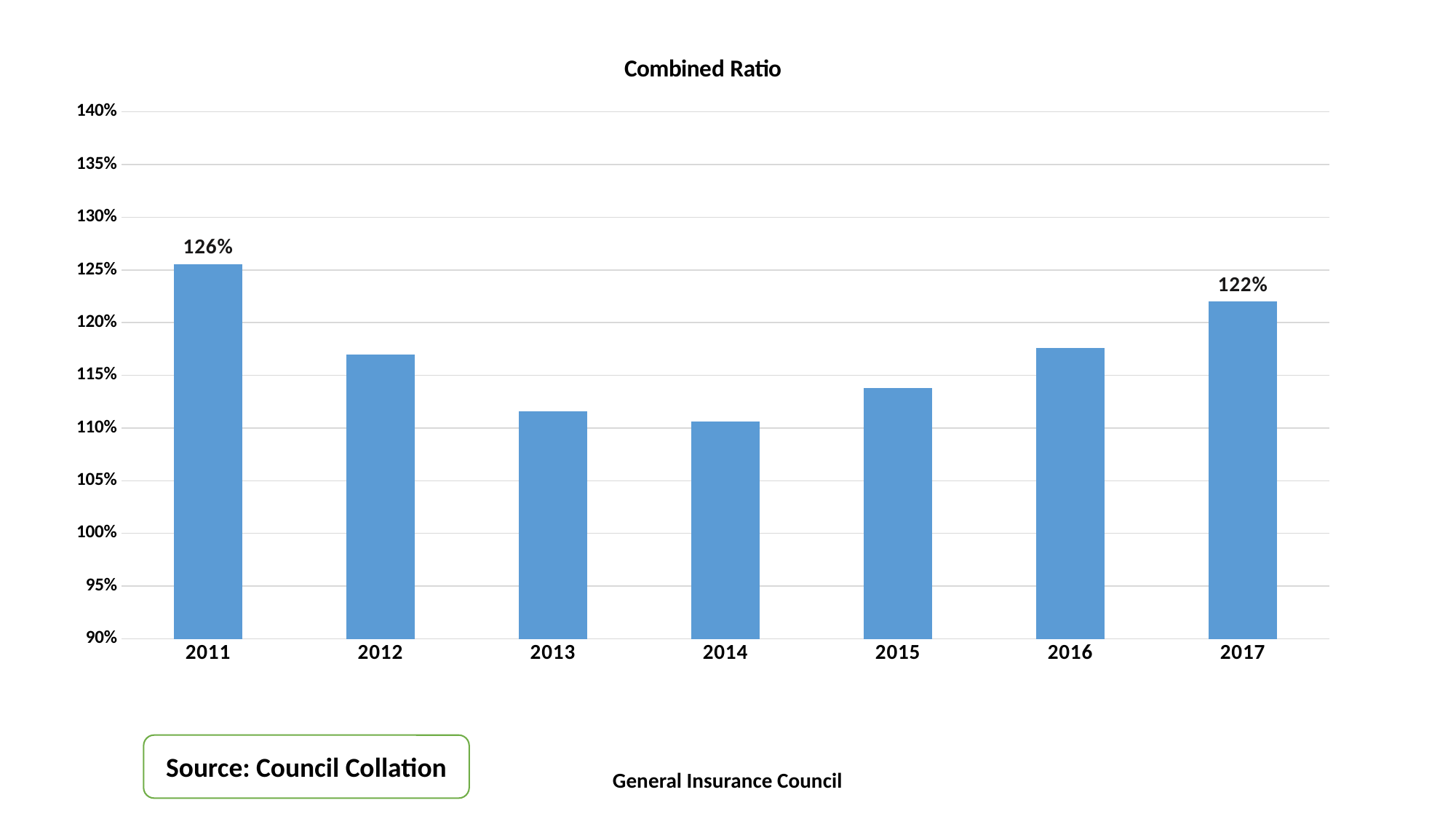
Which is larger, the Combined Ratio in 2011 or in 2017? 2011 Does the Combined Ratio rise or fall from 2014 to 2017? Rises What is the difference between the Combined Ratio in 2011 and in 2017? 4 percentage points How many years are shown on the chart? 7 Is the Combined Ratio for 2014 greater or less than 115%? less Is the Combined Ratio for 2016 greater or less than 115%? greater Is the Combined Ratio for 2013 greater or less than 120%? less What kind of chart is shown on the slide? Bar chart Which year has the highest Combined Ratio? 2011 What is the Combined Ratio for 2017? 122% What is the Combined Ratio for 2011? 126%